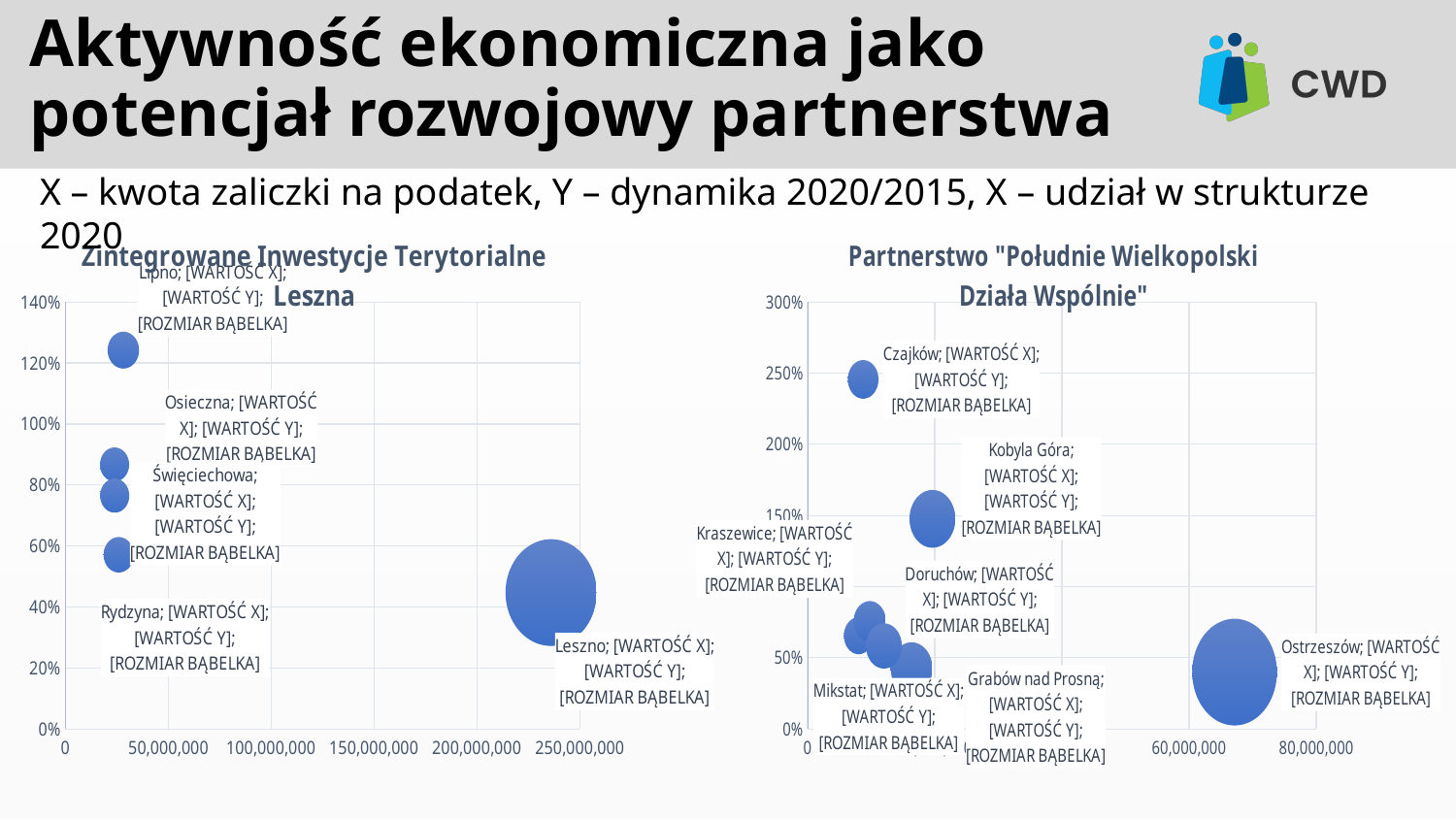
In the right chart (Partnerstwo "Południe Wielkopolski Działa Wspólnie"), which locality has the largest bubble? Ostrzeszów What kind of chart is the left chart titled "Zintegrowane Inwestycje Terytorialne Leszna"? bubble chart In the right chart, which has the higher Y value: Czajków or Ostrzeszów? Czajków In the right chart (Partnerstwo "Południe Wielkopolski Działa Wspólnie"), is the Y value for Czajków greater or less than 200%? greater In the left chart (Zintegrowane Inwestycje Terytorialne Leszna), which locality has the highest value on the Y axis? Lipno In the right chart (Partnerstwo "Południe Wielkopolski Działa Wspólnie"), is the X value for Ostrzeszów greater or less than 60,000,000? greater In the left chart (Zintegrowane Inwestycje Terytorialne Leszna), is the X value for Leszno greater or less than 200,000,000? greater In the left chart (Zintegrowane Inwestycje Terytorialne Leszna), which locality has the largest bubble? Leszno How many localities are plotted in the left chart (Zintegrowane Inwestycje Terytorialne Leszna)? 5